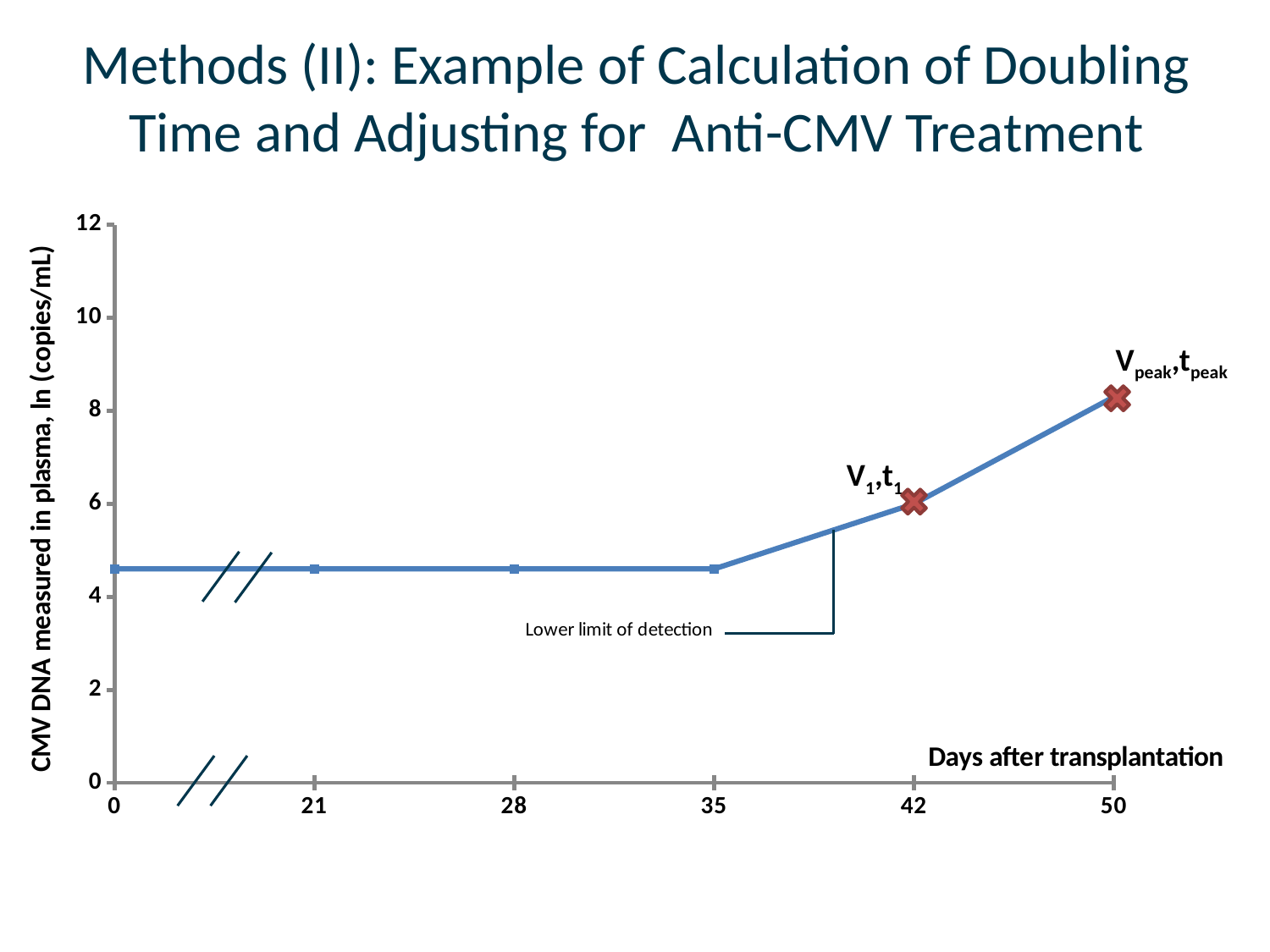
How many data points are plotted on the line? 6 At which day after transplantation is the plotted CMV DNA value highest? 50 Which has the larger value, day 42 or day 28? day 42 What does the annotation pointing to the flat part of the line say? Lower limit of detection Which has the larger value, day 50 or day 42? day 50 Is the value at day 50 greater or less than 6? greater What kind of chart is shown on the slide? line chart Do the values rise or fall between day 35 and day 50? rise What is the title of the x axis? Days after transplantation Is the value at day 42 greater or less than 4? greater Is the value at day 50 greater or less than 10? less